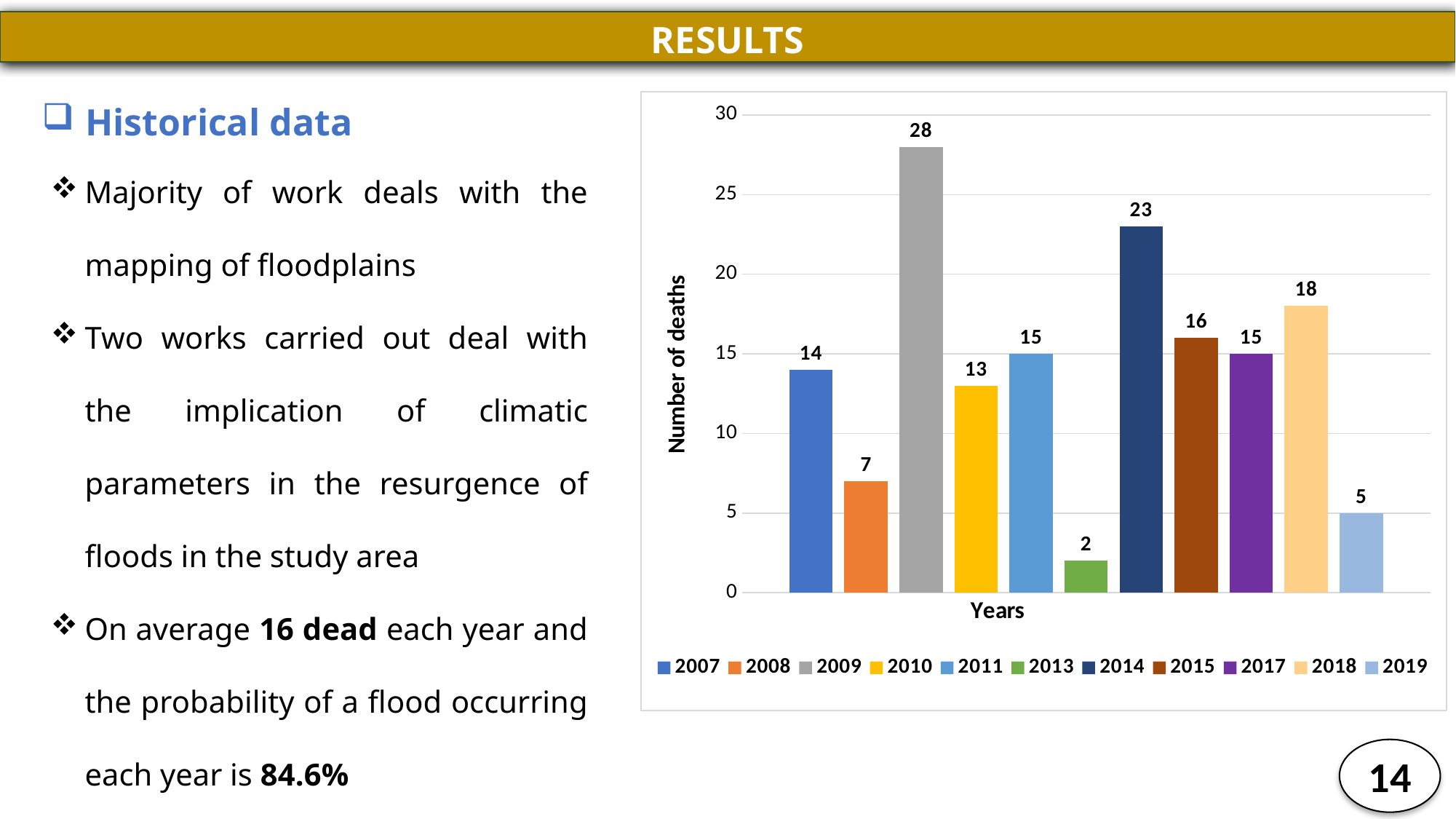
What is the number of deaths for 2013? 2 How many years are shown in the chart? 11 Which year had more deaths, 2015 or 2019? 2015 What type of chart is shown on the slide? Bar chart What is the number of deaths for 2009? 28 What is the difference in number of deaths between 2007 and 2008? 7 What is the difference in number of deaths between 2009 and 2014? 5 Which year has the lowest number of deaths? 2013 What is the number of deaths for 2018? 18 What is the label of the vertical axis of the chart? Number of deaths How many entries does the legend list? 11 Which year has the highest number of deaths? 2009